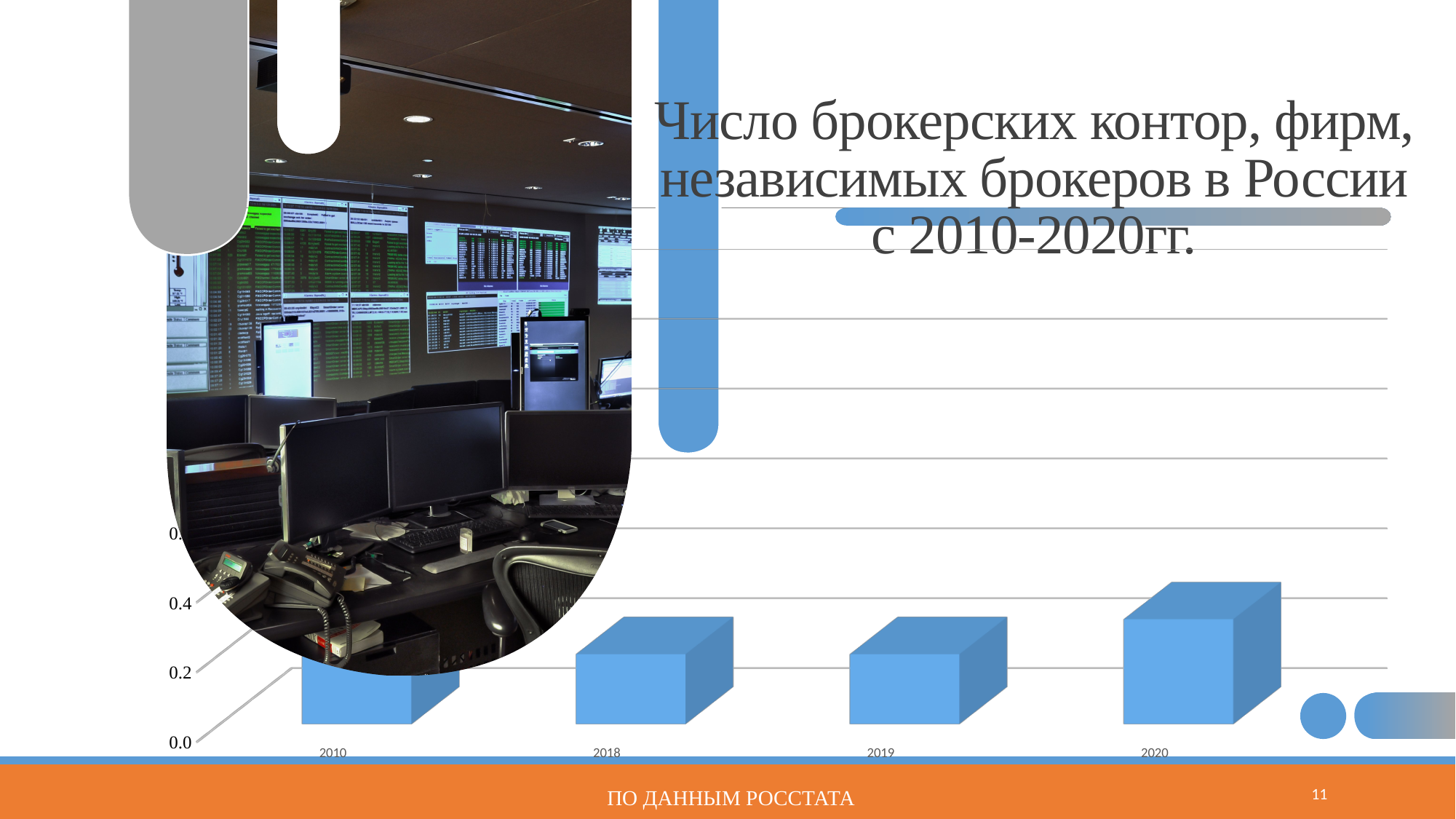
Which is larger, the value for 2020 or the value for 2019? 2020 Which is larger, the value for 2020 or the value for 2018? 2020 What kind of chart is shown on the slide? bar chart Is the value for 2019 greater or less than 0.4? less According to the slide footer, what is the data source for the chart? ПО ДАННЫМ РОССТАТА Is the value for 2018 greater or less than 0.4? less How many years (categories) are shown on the x axis of the chart? 4 Is the value for 2020 greater or less than 0.2? greater What is the title of the chart on the slide? Число брокерских контор, фирм, независимых брокеров в России с 2010-2020гг.